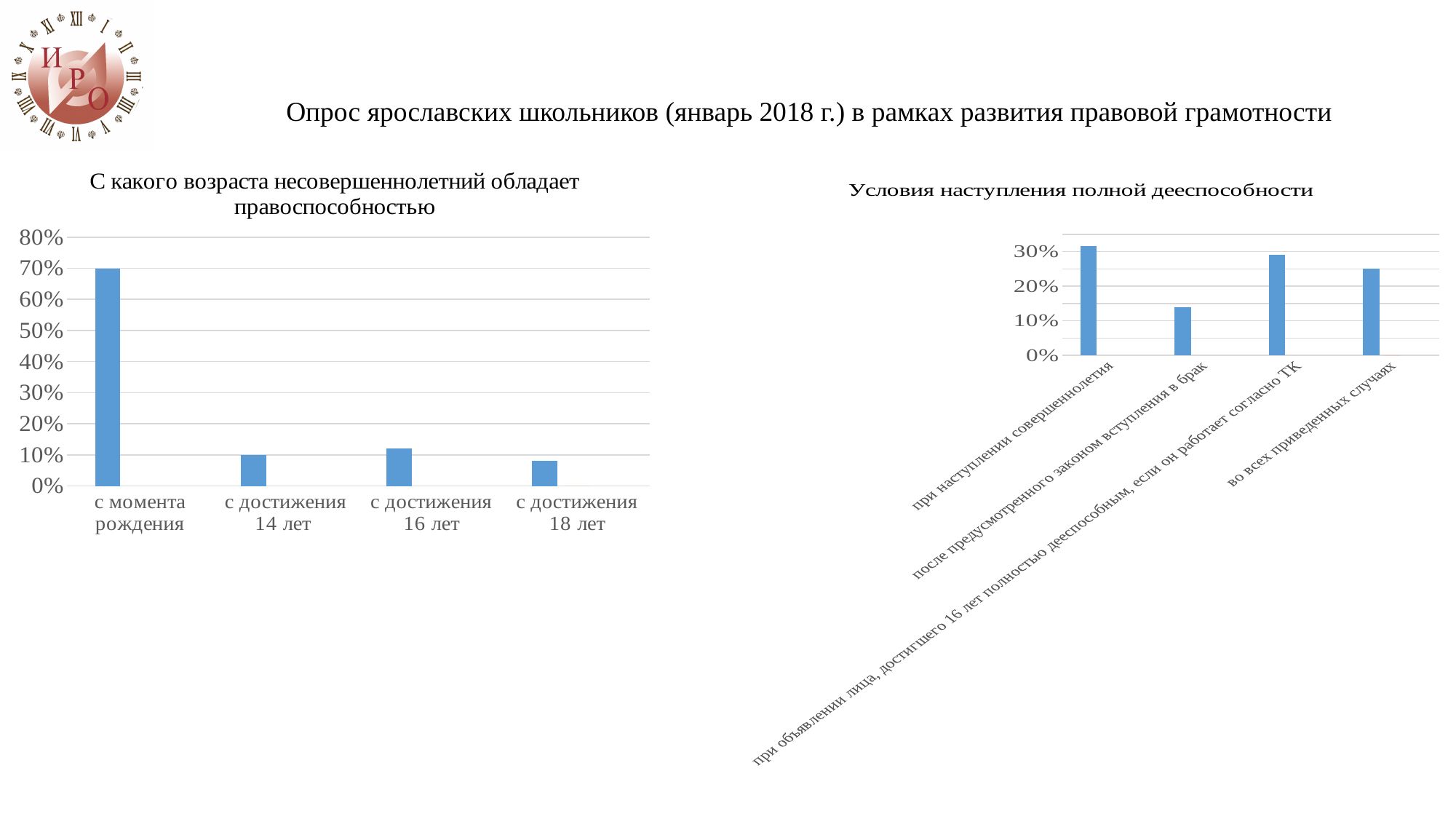
In the chart 'С какого возраста несовершеннолетний обладает правоспособностью', which category has the lowest value? с достижения 18 лет In the chart 'Условия наступления полной дееспособности', which is larger: the value for 'во всех приведенных случаях' or the value for 'после предусмотренного законом вступления в брак'? во всех приведенных случаях In the chart 'С какого возраста несовершеннолетний обладает правоспособностью', what is the value for 'с момента рождения'? 70% In the chart 'С какого возраста несовершеннолетний обладает правоспособностью', which category has the highest value? с момента рождения In the chart 'С какого возраста несовершеннолетний обладает правоспособностью', what is the value for 'с достижения 14 лет'? 10% In the chart 'С какого возраста несовершеннолетний обладает правоспособностью', how many categories are shown? 4 In the chart 'С какого возраста несовершеннолетний обладает правоспособностью', is the value for 'с достижения 16 лет' greater or less than 20%? less In the chart 'Условия наступления полной дееспособности', which category has the highest value? при наступлении совершеннолетия In the chart 'С какого возраста несовершеннолетний обладает правоспособностью', what is the difference between the values for 'с момента рождения' and 'с достижения 14 лет'? 60% In the chart 'Условия наступления полной дееспособности', is the value for 'при наступлении совершеннолетия' greater or less than 30%? greater What type of chart is 'Условия наступления полной дееспособности'? bar chart In the chart 'Условия наступления полной дееспособности', which category has the lowest value? после предусмотренного законом вступления в брак